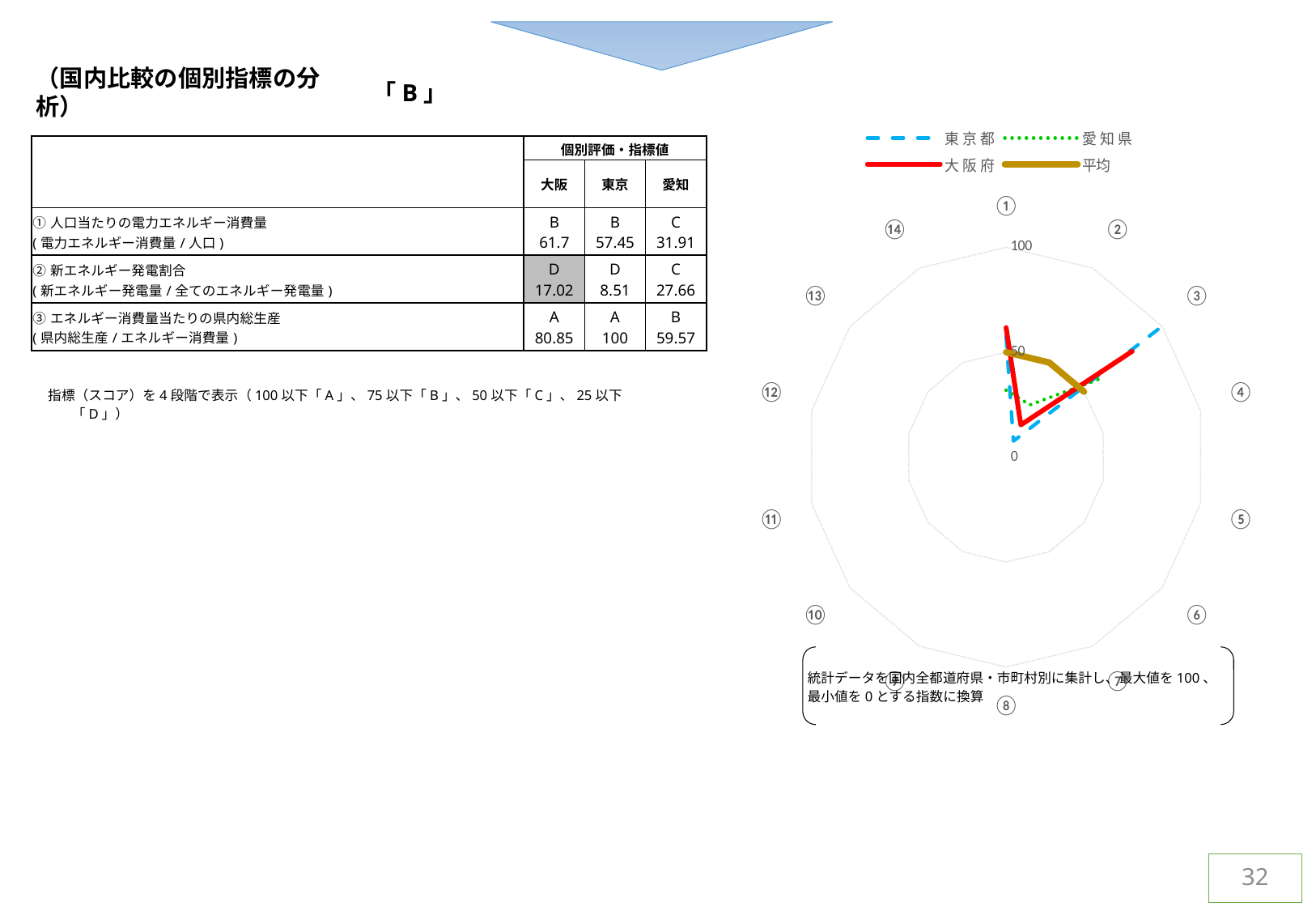
What is the highest value shown on the radar chart's scale? 100 What kind of chart is shown on the right side of the slide? radar chart Which series in the radar chart legend is drawn as a blue dashed line? 東京都 How many series does the legend of the radar chart list? 4 How many numbered axes does the radar chart have? 14 What is the lowest value shown on the radar chart's scale? 0 Which series in the radar chart legend is drawn as a solid red line? 大阪府 Is the highest value plotted for 東京都 on the radar chart greater or less than 50? greater